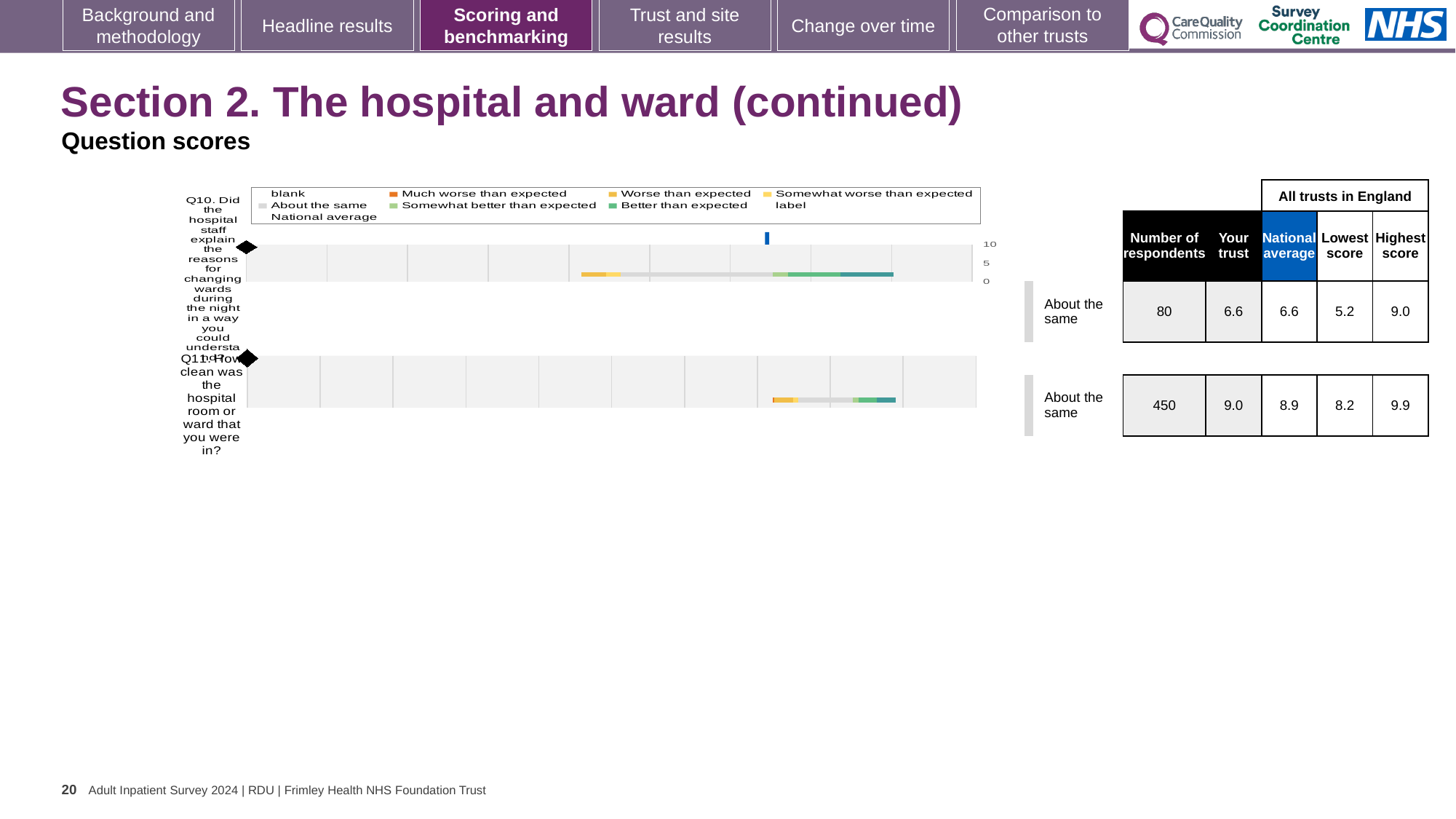
In the table beside the chart, what is the lowest score among all trusts in England for Q10? 5.2 In the chart legend, which category is shown in dark orange? Much worse than expected What kind of chart is used to show the question scores for Q10 and Q11? bar chart What is the difference between the highest score and the lowest score for Q11 in the table? 1.7 In the table beside the chart, how many respondents answered Q11 (how clean was the hospital room or ward)? 450 What benchmark category is shown for Q10 next to the chart? About the same For Q11, which is larger: the 'Your trust' score or the national average? Your trust In the table beside the chart, what is the national average score for Q11? 8.9 In the table beside the chart, what is the 'Your trust' score for Q10 (explaining reasons for changing wards during the night)? 6.6 Which of the two questions has the higher 'Your trust' score? Q11 What is the difference between the highest score and the lowest score for Q10 in the table? 3.8 How many questions are plotted in the question scores chart? 2